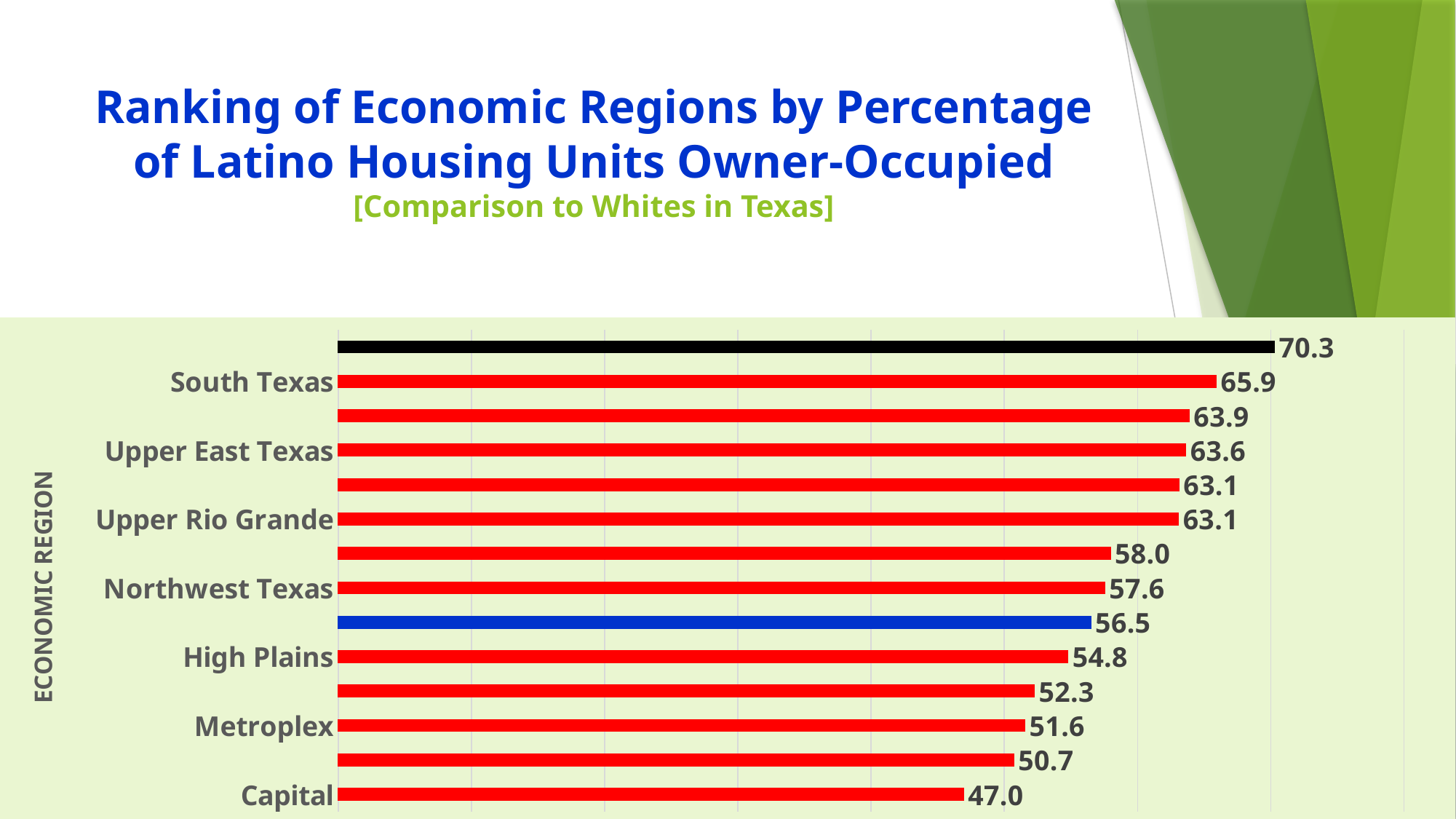
What is the value for High Plains? 54.8 What is the value for Metroplex? 51.6 What is the difference between the values for South Texas and Capital? 18.9 Which is larger, the value for South Texas or the value for Metroplex? South Texas Which labeled region has the lowest value? Capital How many bars are plotted on the chart? 14 What kind of chart is shown on the slide? Bar chart What is the value for South Texas? 65.9 What is the value for Northwest Texas? 57.6 What is the value for Upper Rio Grande? 63.1 What is the value for Upper East Texas? 63.6 What is the highest value shown on the chart? 70.3